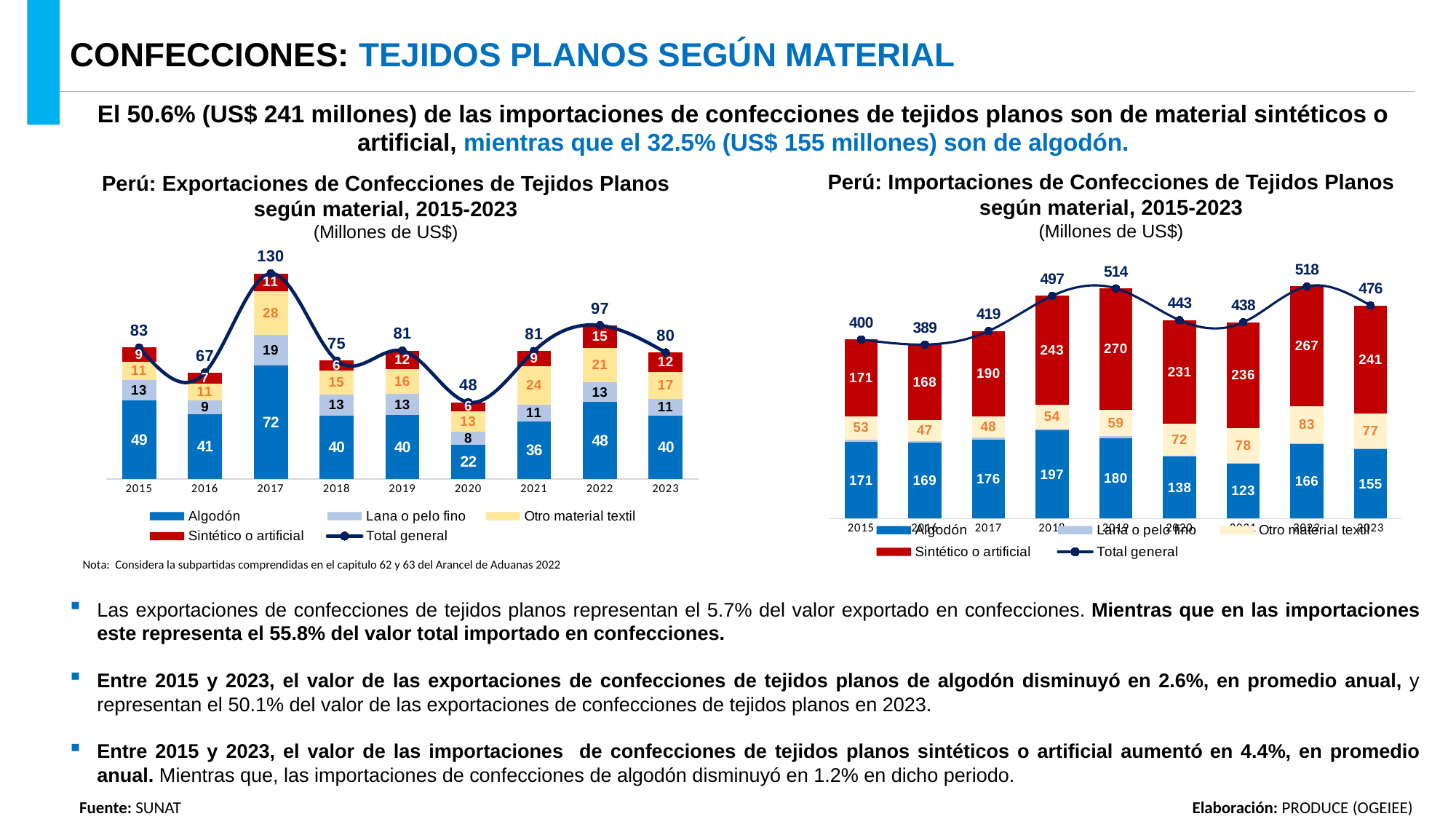
How many years are shown on the x axis of the imports chart (right)? 9 In the exports chart (left), what is the difference between the Total general for 2022 and 2023? 17 In the exports chart (left), what is the Algodón value for 2017? 72 In the imports chart (right), which year has the lowest Algodón value? 2021 In the exports chart (left), which year has the highest Total general? 2017 In the imports chart (right), what is the difference between the Total general for 2015 and 2023? 76 In the imports chart (right), is the Algodón value for 2018 larger or the Sintético o artificial value for 2018? Sintético o artificial In the imports chart (right), which year has the highest Total general? 2022 What kind of chart is the exports chart (left)? Stacked bar chart with a line In the exports chart (left), which year has the lowest Total general? 2020 In the exports chart (left), how many series does the legend list? 5 In the imports chart (right), what is the Sintético o artificial value for 2019? 270